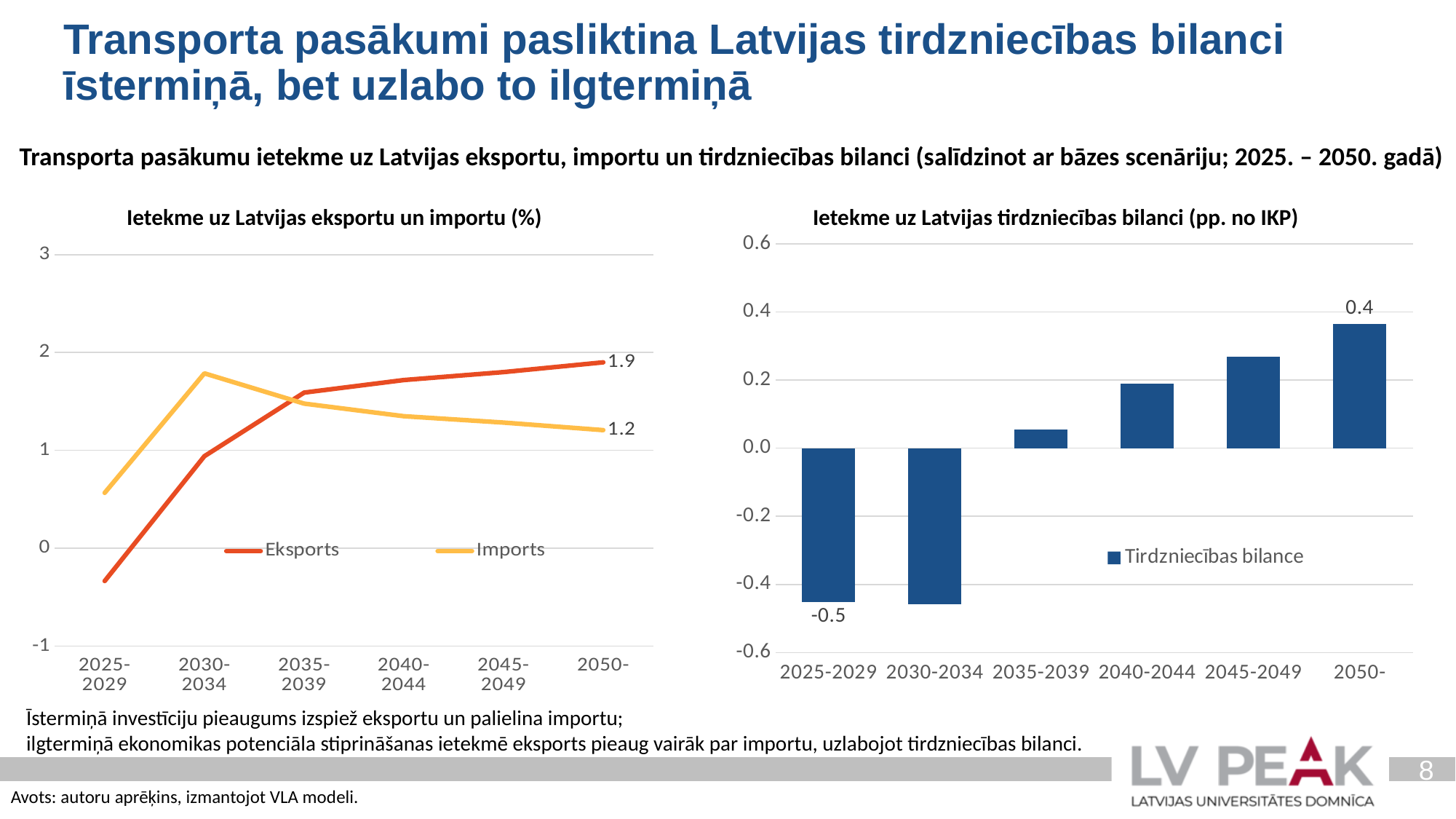
In the chart 'Ietekme uz Latvijas eksportu un importu (%)', what is the value for Imports in the 2050- period? 1.2 What kind of chart is 'Ietekme uz Latvijas tirdzniecības bilanci (pp. no IKP)'? bar chart What kind of chart is 'Ietekme uz Latvijas eksportu un importu (%)'? line chart In the chart 'Ietekme uz Latvijas tirdzniecības bilanci (pp. no IKP)', what is the value for 2025-2029? -0.5 In the chart 'Ietekme uz Latvijas eksportu un importu (%)', which series has the higher value in the 2025-2029 period, Eksports or Imports? Imports In the chart 'Ietekme uz Latvijas eksportu un importu (%)', what is the value for Eksports in the 2050- period? 1.9 In the chart 'Ietekme uz Latvijas tirdzniecības bilanci (pp. no IKP)', how many periods are shown on the x axis? 6 In the chart 'Ietekme uz Latvijas tirdzniecības bilanci (pp. no IKP)', what is the value for 2050-? 0.4 In the chart 'Ietekme uz Latvijas eksportu un importu (%)', how many series does the legend list? 2 In the chart 'Ietekme uz Latvijas tirdzniecības bilanci (pp. no IKP)', which period has the highest value? 2050- In the chart 'Ietekme uz Latvijas eksportu un importu (%)', is the value for Eksports in 2025-2029 greater or less than 0? less In the chart 'Ietekme uz Latvijas eksportu un importu (%)', what is the difference between Eksports and Imports in the 2050- period? 0.7